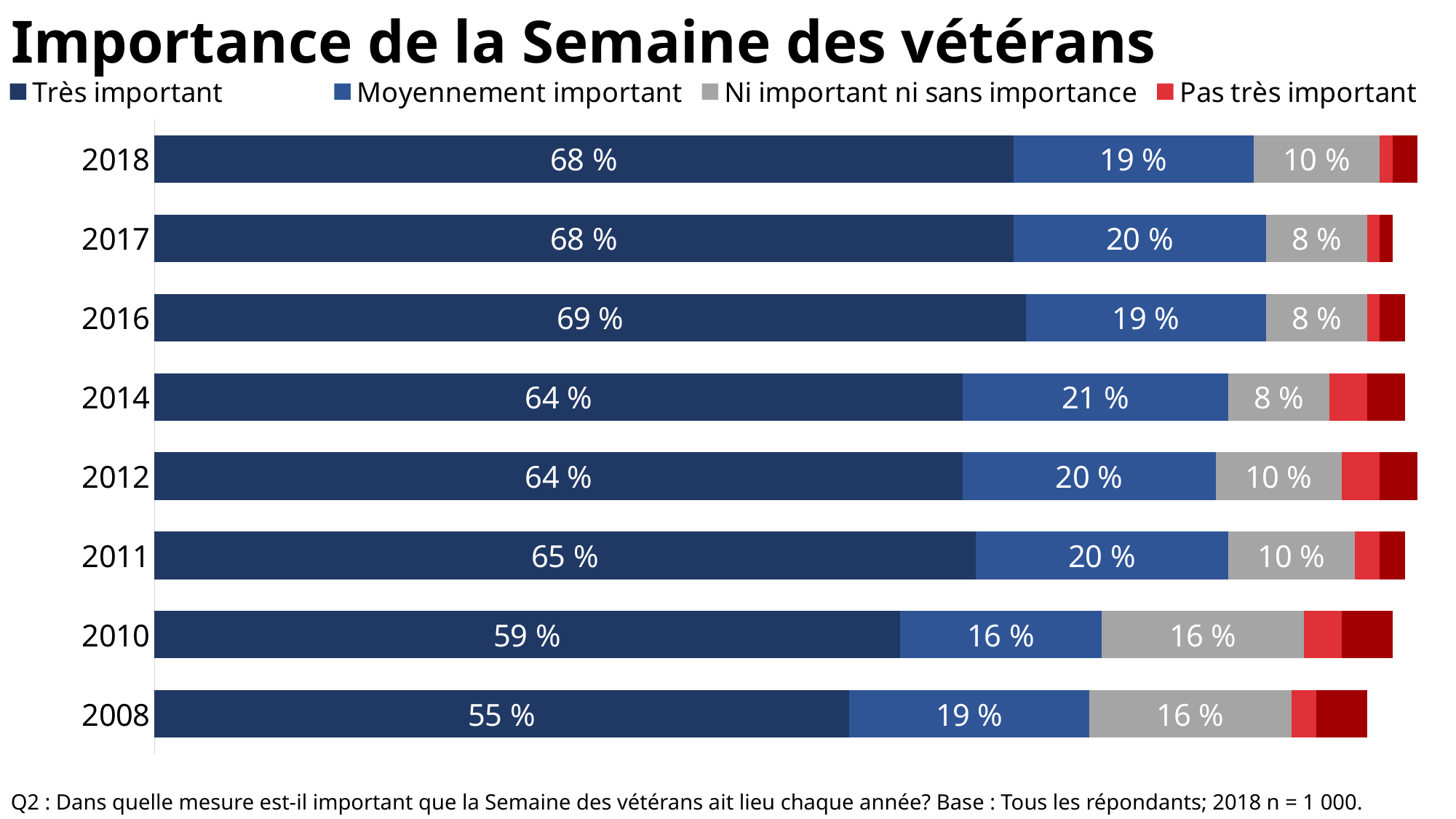
What kind of chart is shown on the slide? Stacked bar chart What is the "Ni important ni sans importance" value for 2010? 16 % Which year has a larger "Moyennement important" value, 2014 or 2010? 2014 What is the "Moyennement important" value for 2014? 21 % How many years are shown on the chart? 8 What is the title of the chart? Importance de la Semaine des vétérans How many series does the legend list? 4 Does the "Très important" share rise or fall from 2008 to 2018? Rise In which year was the "Très important" share the highest? 2016 What is the difference between the "Très important" values for 2018 and 2008? 13 % What percentage of respondents said the Semaine des vétérans was "Très important" in 2018? 68 % In which year was the "Très important" share the lowest? 2008